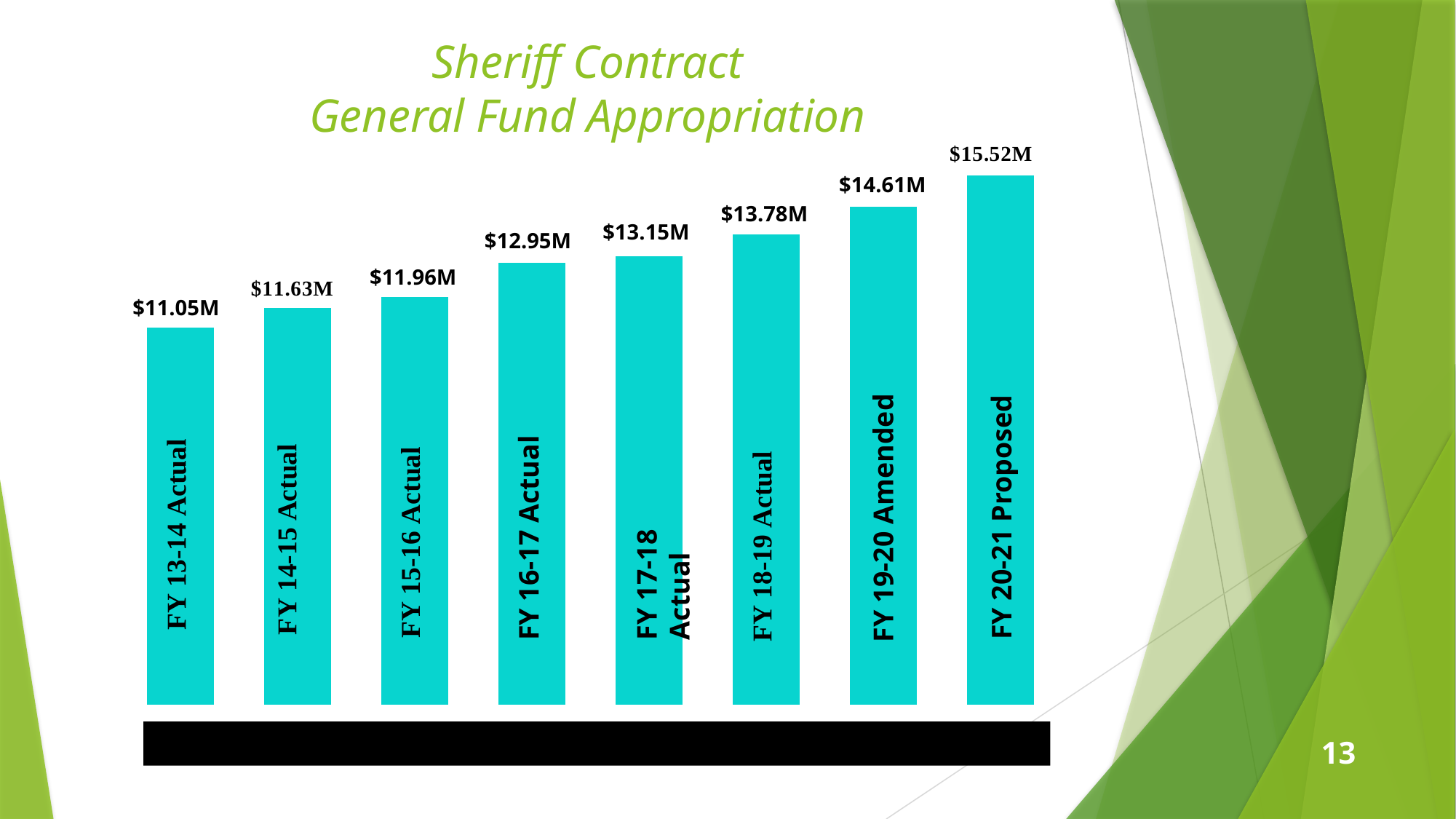
Which fiscal year has the highest General Fund Appropriation? FY 20-21 Proposed What is the General Fund Appropriation for the Sheriff Contract in FY 13-14 Actual? $11.05M How many fiscal years are shown in the chart? 8 What is the value shown for FY 19-20 Amended? $14.61M What is the value shown for FY 17-18 Actual? $13.15M Which fiscal year has the lowest General Fund Appropriation? FY 13-14 Actual What is the title of the chart? Sheriff Contract General Fund Appropriation Which is larger, the value for FY 18-19 Actual or FY 17-18 Actual? FY 18-19 Actual What is the difference between the FY 16-17 Actual and FY 15-16 Actual values? $0.99M What is the difference between the FY 20-21 Proposed and FY 19-20 Amended values? $0.91M Do the values rise or fall from FY 13-14 to FY 20-21? Rise What kind of chart is shown on the slide? Bar chart